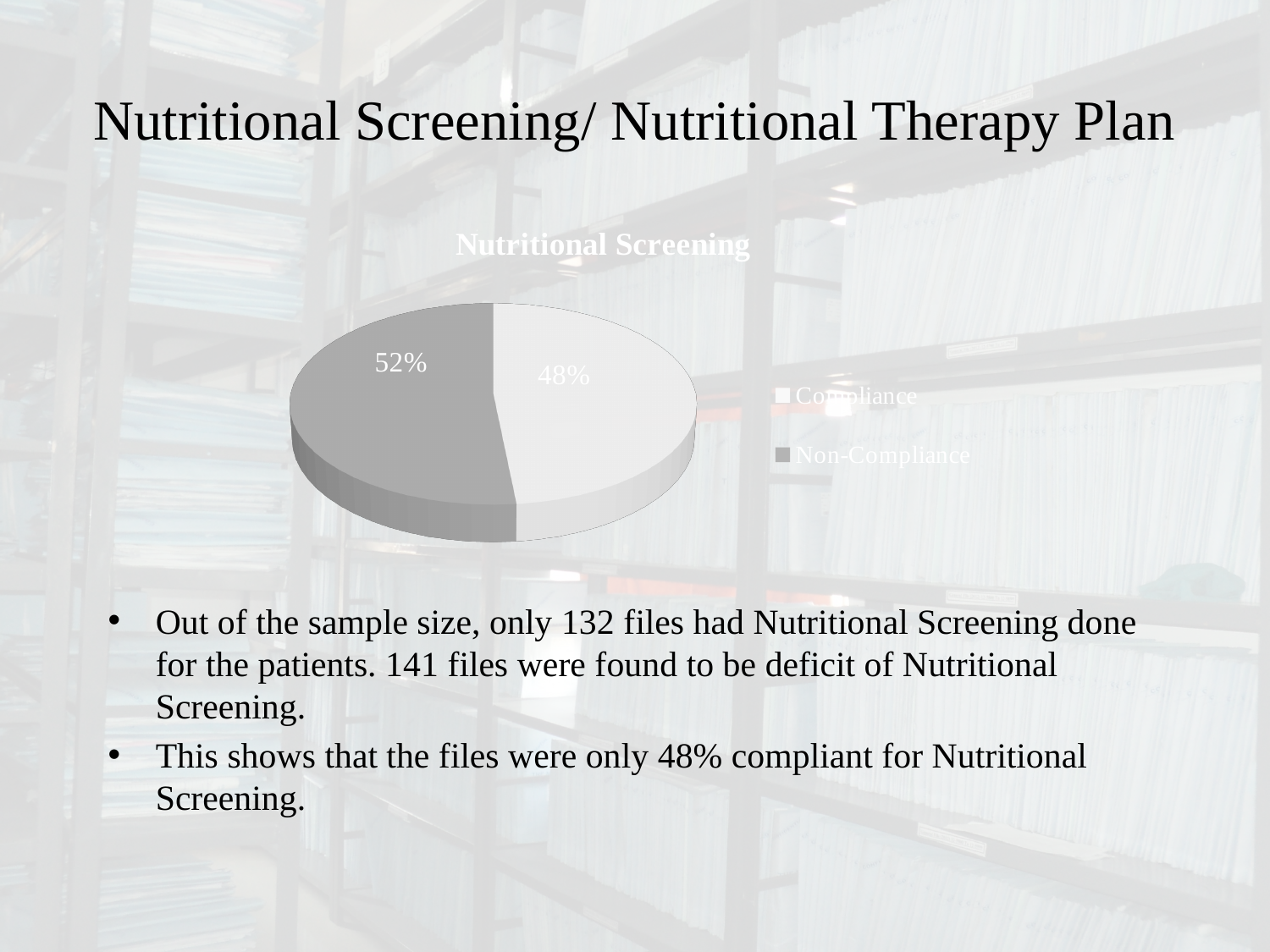
Which legend entry is shown in the darker grey colour? Non-Compliance How many entries does the legend list? 2 What is the difference in percentage points between the Non-Compliance and Compliance slices? 4 What percentage of the pie is labelled Compliance? 48% Is the Compliance share greater or less than 50%? less What type of chart is shown on the slide? Pie chart Which category has the smallest share of the pie? Compliance What percentage of the pie is labelled Non-Compliance? 52% Which slice of the pie is larger, Compliance or Non-Compliance? Non-Compliance How many slices does the pie chart have? 2 What is the title of the chart? Nutritional Screening